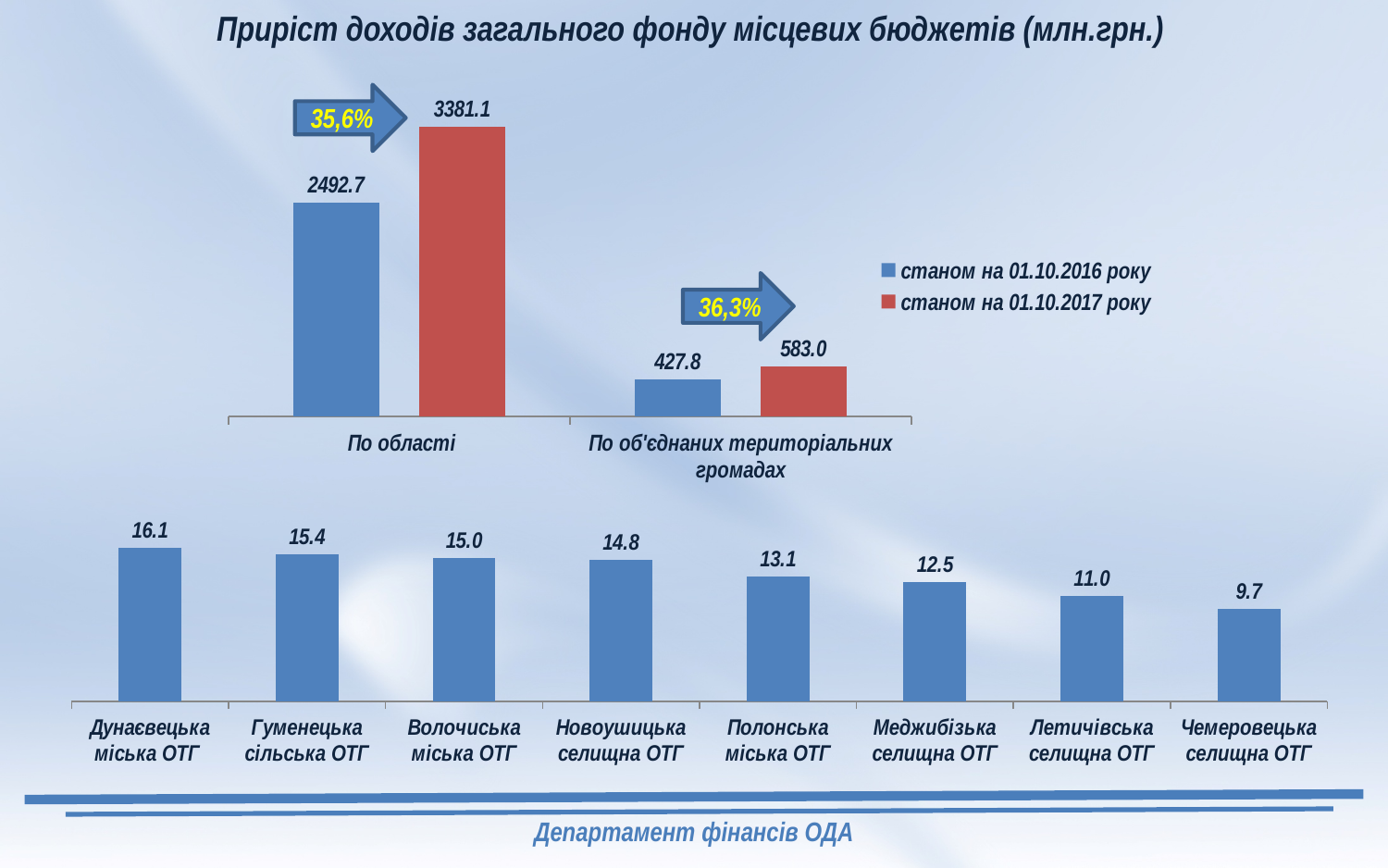
In the bottom chart, what is the difference between 'Гуменецька сільська ОТГ' and 'Летичівська селищна ОТГ'? 4.4 In the bottom chart, how many categories are shown? 8 In the bottom chart, do the values rise or fall from left to right? fall In the top chart, what is the value for 'По об'єднаних територіальних громадах' as of 01.10.2016? 427.8 What kind of chart is the bottom chart? bar chart In the top chart, what is the difference between the 2017 and 2016 values for 'По області'? 888.4 In the top chart, what percentage growth is shown in the arrow for 'По об'єднаних територіальних громадах'? 36,3% In the bottom chart, which category has the lowest value? Чемеровецька селищна ОТГ In the bottom chart, what is the value for 'Полонська міська ОТГ'? 13.1 In the bottom chart, which category has the highest value? Дунаєвецька міська ОТГ In the top chart, how many series does the legend list? 2 In the top chart, what is the value for 'По області' as of 01.10.2017? 3381.1